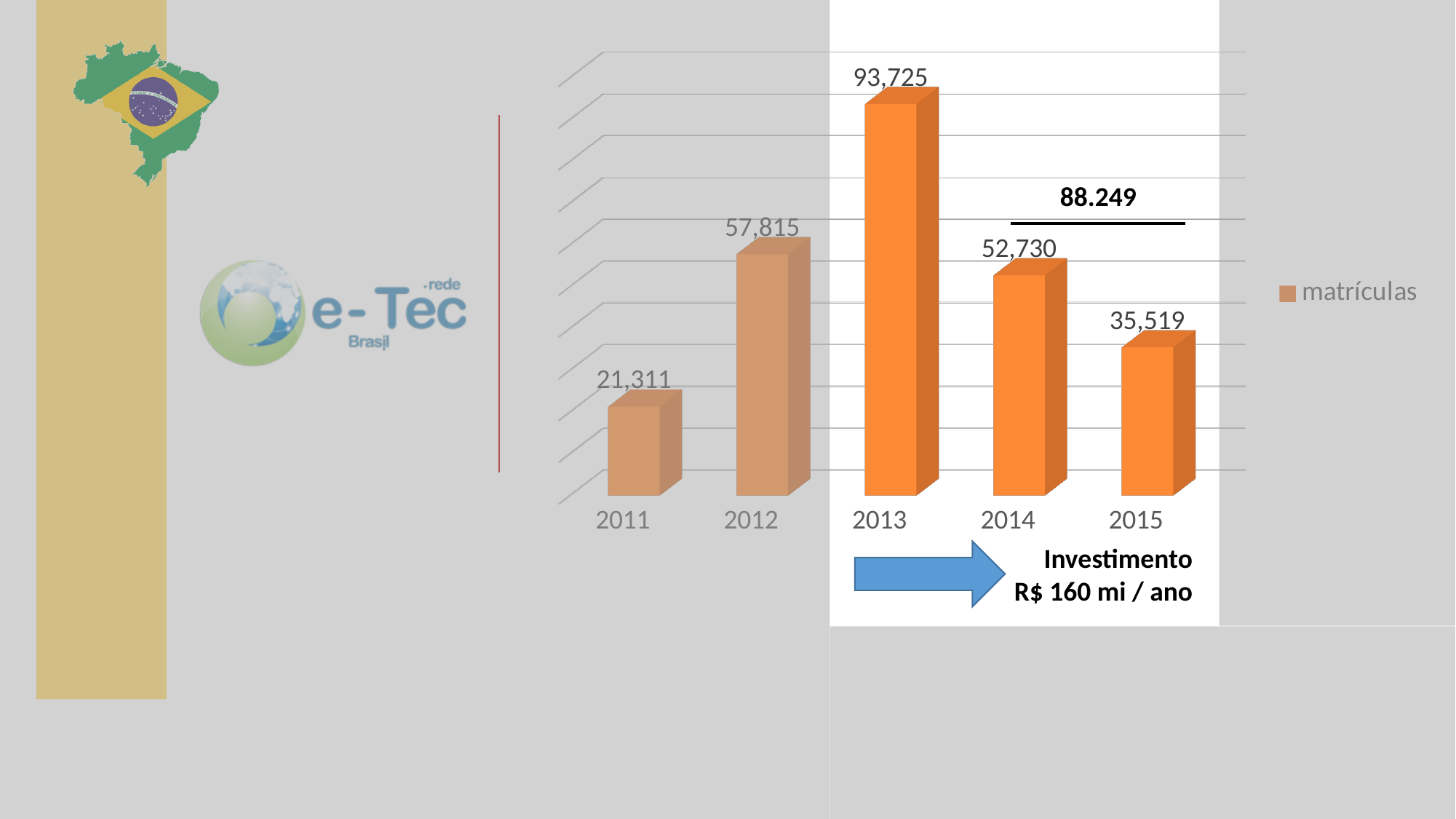
How many years are shown on the x axis? 5 What is the value for 2011? 21,311 What is the value for 2015? 35,519 Which year has the highest value? 2013 How many series does the legend list? 1 Which is larger, the value for 2012 or the value for 2014? 2012 What is the difference between the values for 2012 and 2011? 36,504 What is the name of the series shown in the legend? matrículas What is the value for 2013? 93,725 What is the difference between the values for 2013 and 2014? 40,995 Which year has the lowest value? 2011 What kind of chart is shown? bar chart